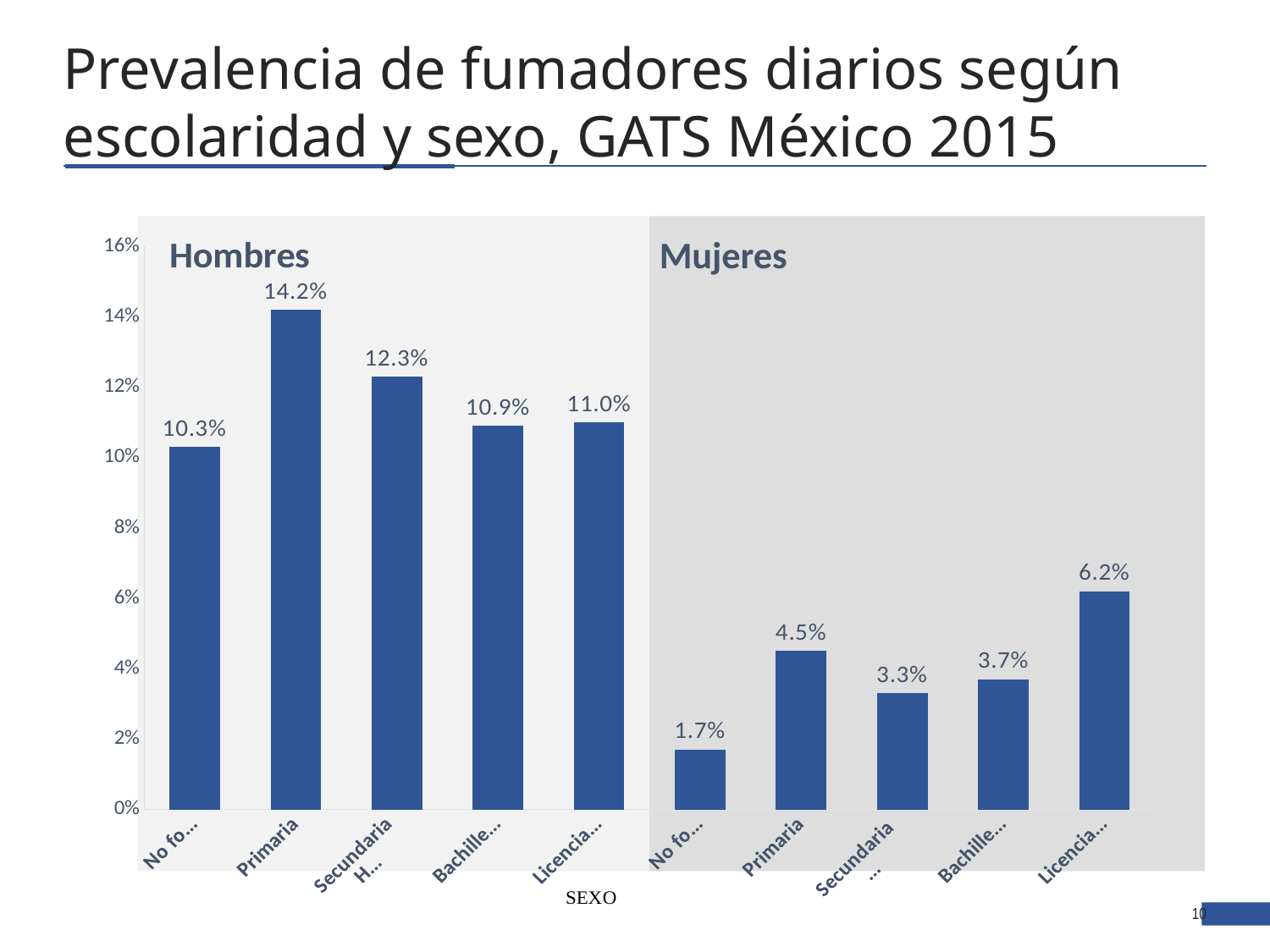
What is the value for Primaria in the Hombres group? 14.2% What is the value for Secundaria in the Mujeres group? 3.3% What kind of chart is shown on the slide? Bar chart What is the difference between the Primaria values for Hombres and Mujeres? 9.7 percentage points What are the two group labels shown inside the chart area? Hombres and Mujeres What is the lowest value shown in the Mujeres group? 1.7% Is the Primaria value for Mujeres greater or less than 4%? greater What is the value for Primaria in the Mujeres group? 4.5% What is the lowest value shown in the Hombres group? 10.3% How many bars are plotted in the chart in total? 10 Which education category has the highest value in the Hombres group? Primaria Which is larger, the Secundaria value for Hombres or for Mujeres? Hombres